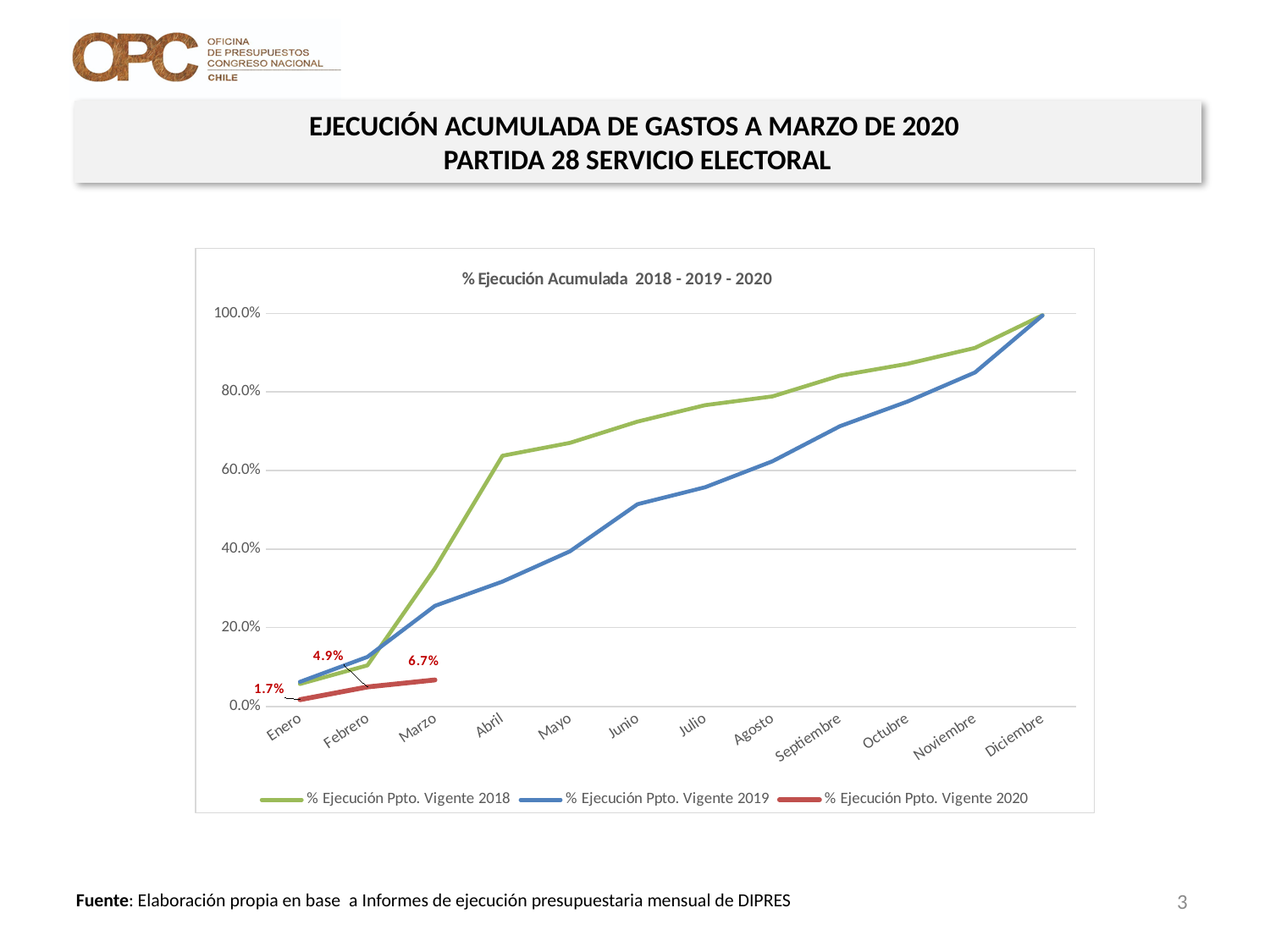
How many months are shown along the x axis? 12 In Abril, which series has the larger value: % Ejecución Ppto. Vigente 2018 or % Ejecución Ppto. Vigente 2019? % Ejecución Ppto. Vigente 2018 Is the value for % Ejecución Ppto. Vigente 2018 in Abril greater or less than 60.0%? greater What is the value for % Ejecución Ppto. Vigente 2020 in Enero? 1.7% What is the difference between the 2020 values for Marzo and Enero? 5.0% What is the value for % Ejecución Ppto. Vigente 2020 in Marzo? 6.7% What kind of chart is shown on the slide? line chart Do the values for % Ejecución Ppto. Vigente 2020 rise or fall from Enero to Marzo? rise Which month has the highest value for the % Ejecución Ppto. Vigente 2020 series? Marzo How many series does the legend list? 3 What is the value for % Ejecución Ppto. Vigente 2020 in Febrero? 4.9% What is the title of the chart? % Ejecución Acumulada 2018 - 2019 - 2020